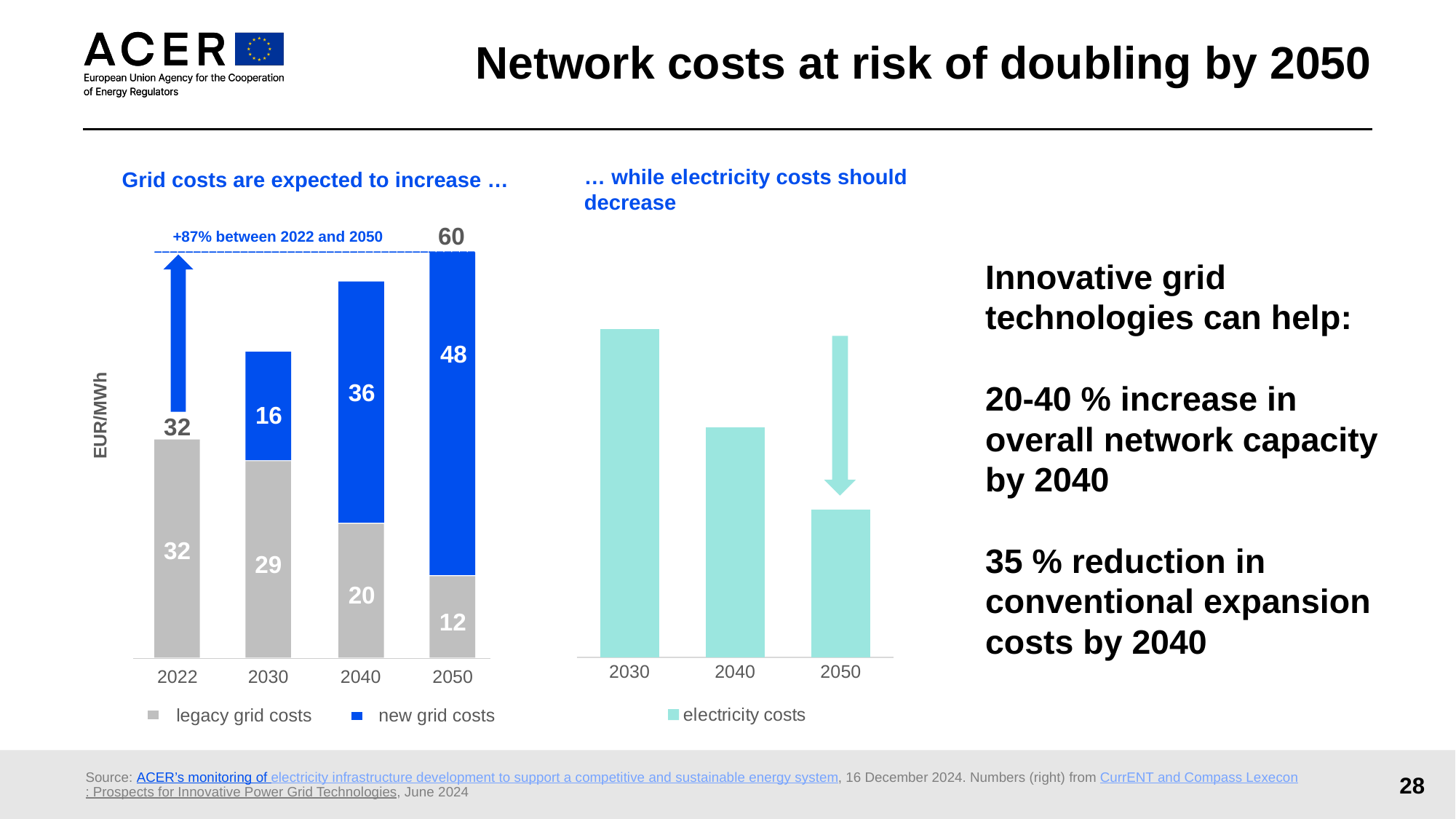
How many years are shown on the x axis of the chart titled '… while electricity costs should decrease'? 3 In the chart titled 'Grid costs are expected to increase …', which year has the highest new grid costs? 2050 In the chart titled 'Grid costs are expected to increase …', which is larger in 2040: legacy grid costs or new grid costs? new grid costs In the chart titled 'Grid costs are expected to increase …', which year has the lowest legacy grid costs? 2050 In the chart titled '… while electricity costs should decrease', do the electricity costs rise or fall from 2030 to 2050? fall In the chart titled 'Grid costs are expected to increase …', what is the legacy grid costs value for 2022? 32 How many series does the legend list in the chart titled 'Grid costs are expected to increase …'? 2 In the chart titled 'Grid costs are expected to increase …', what is the legacy grid costs value for 2050? 12 In the chart titled 'Grid costs are expected to increase …', what is the new grid costs value for 2040? 36 In the chart titled 'Grid costs are expected to increase …', what is the total of the stacked bar for 2050? 60 In the chart titled 'Grid costs are expected to increase …', what is the difference between the new grid costs in 2050 and in 2030? 32 In the chart titled 'Grid costs are expected to increase …', what is the total of the stacked bar for 2030? 45